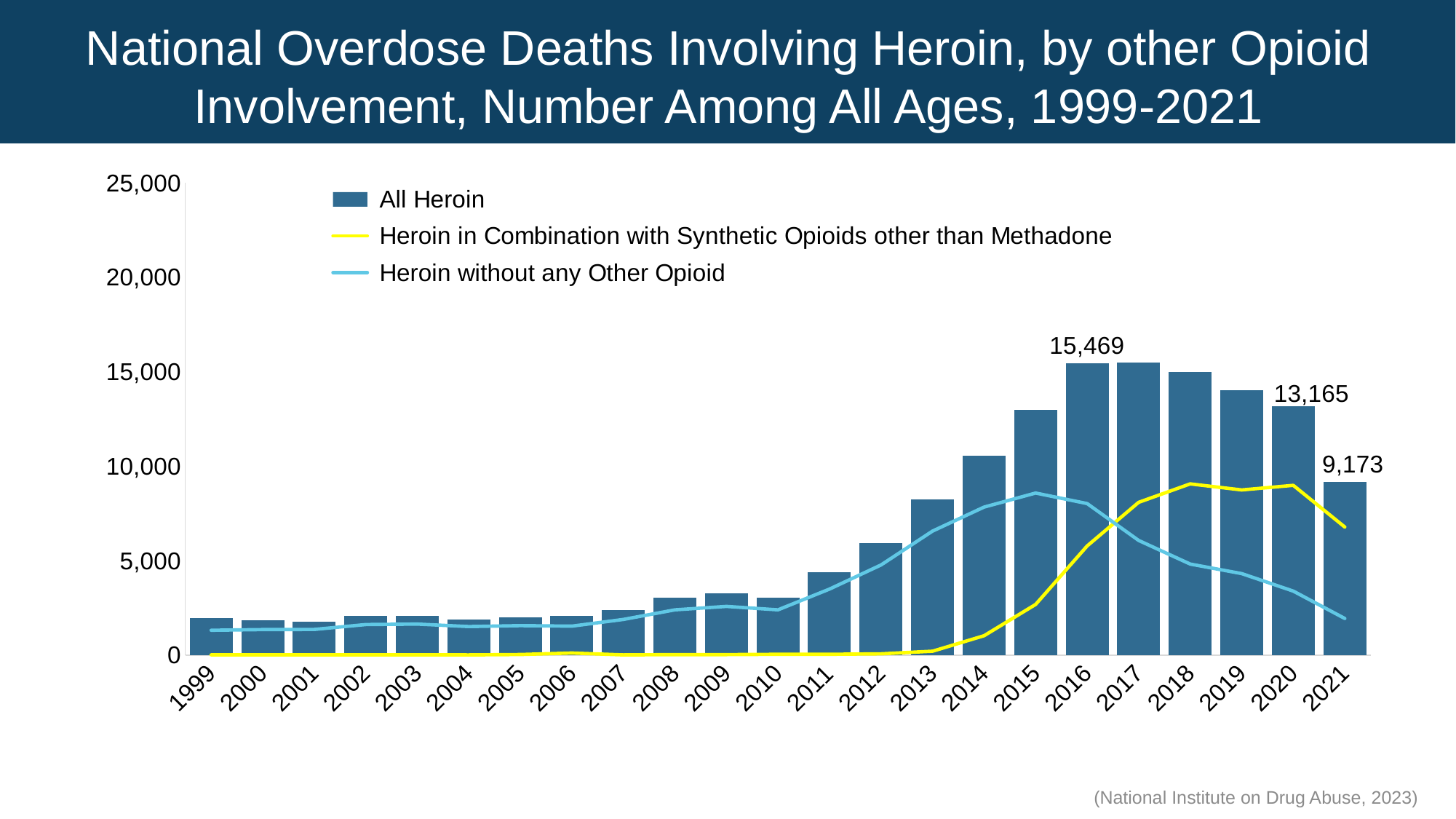
What is the value of the All Heroin bar for 2021? 9,173 What is the value of the All Heroin bar for 2016? 15,469 By how much did the All Heroin value fall from 2020 to 2021? 3,992 In 2021, which line is higher: Heroin in Combination with Synthetic Opioids other than Methadone or Heroin without any Other Opioid? Heroin in Combination with Synthetic Opioids other than Methadone Is the All Heroin value for 2011 greater or less than 5,000? less What is the difference between the All Heroin values for 2016 and 2020? 2,304 Is the Heroin without any Other Opioid value for 2021 greater or less than 5,000? less What is the value of the All Heroin bar for 2020? 13,165 How many series does the legend list? 3 Which year has the larger All Heroin value, 2016 or 2021? 2016 How many years are shown on the x axis? 23 Is the All Heroin value for 2014 greater or less than 10,000? greater